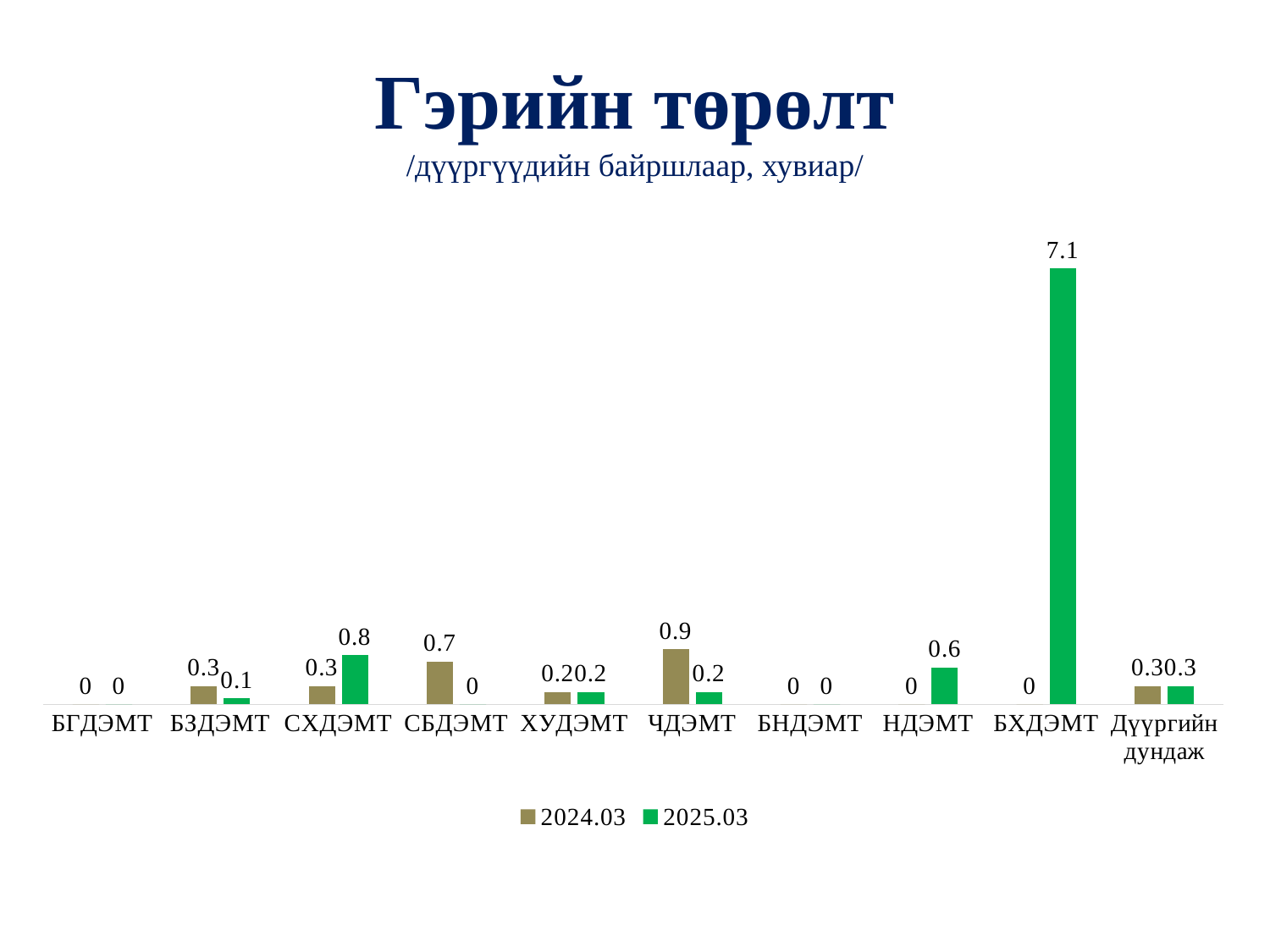
Which category has the highest value in the 2025.03 series? БХДЭМТ What is the difference between the 2025.03 and 2024.03 values for СХДЭМТ? 0.5 What is the value for БХДЭМТ in the 2025.03 series? 7.1 What kind of chart is shown on the slide? Bar chart Which category has the highest value in the 2024.03 series? ЧДЭМТ What is the value for СБДЭМТ in the 2025.03 series? 0 Which is larger for БЗДЭМТ: the 2024.03 value or the 2025.03 value? 2024.03 What is the value for ЧДЭМТ in the 2024.03 series? 0.9 How many categories are shown on the x axis? 10 What is the value for НДЭМТ in the 2025.03 series? 0.6 How many series does the legend list? 2 What is the title of the chart? Гэрийн төрөлт